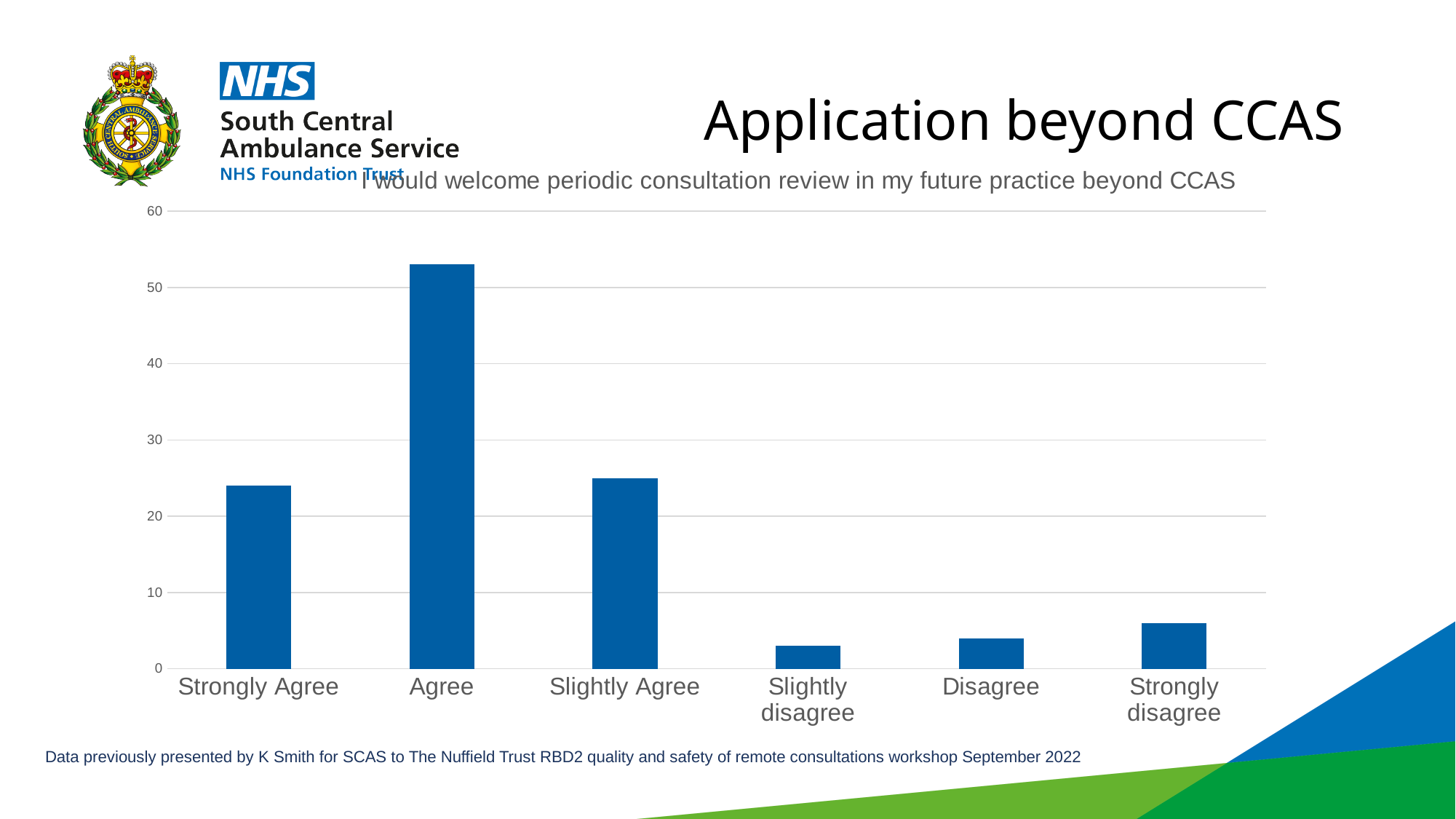
Is the value for Strongly disagree greater or less than 10? less What is the title of the chart? I would welcome periodic consultation review in my future practice beyond CCAS Which is larger, the value for Agree or the value for Strongly Agree? Agree Which is larger, the value for Strongly disagree or the value for Slightly disagree? Strongly disagree Is the value for Slightly Agree greater or less than 30? less Is the value for Strongly Agree greater or less than 20? greater Which response category has the highest value? Agree What is the highest value shown on the y axis? 60 What kind of chart is shown on the slide? Bar chart How many response categories are shown on the x axis? 6